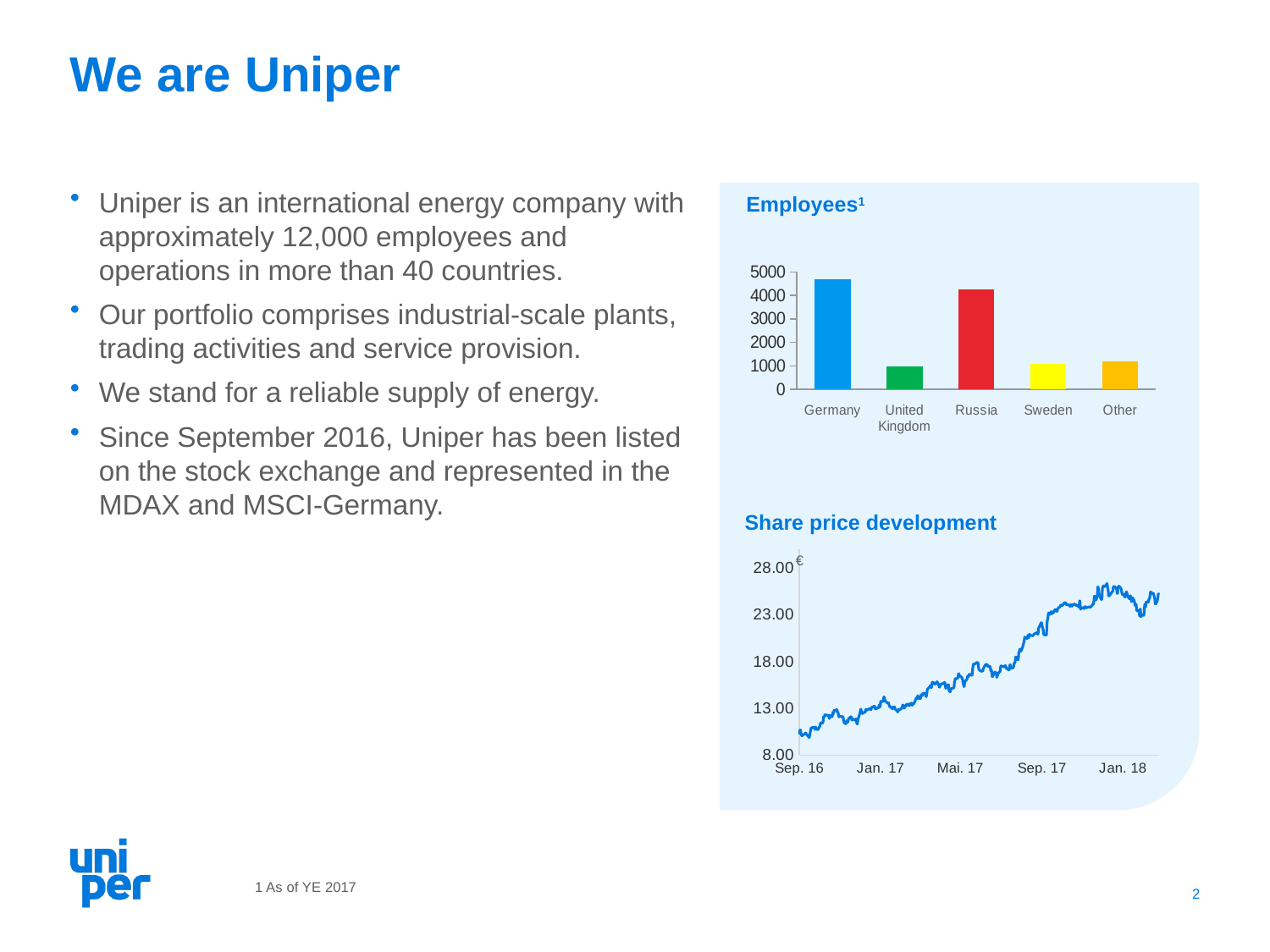
On the Employees chart, how many categories are shown on the x axis? 5 What kind of chart is the Employees chart? bar chart On the Employees chart, which is larger, the value for Germany or the value for Russia? Germany On the Employees chart, is the value for United Kingdom greater or less than 2000? less On the Share price development chart, is the share price at Sep. 16 greater or less than 13.00? less On the Employees chart, is the value for Germany greater or less than 4000? greater On the Employees chart, which country has the highest number of employees? Germany What kind of chart is the Share price development chart? line chart On the Share price development chart, what currency symbol is shown on the y axis? € On the Share price development chart, does the share price generally rise or fall from Sep. 16 to Jan. 18? rise